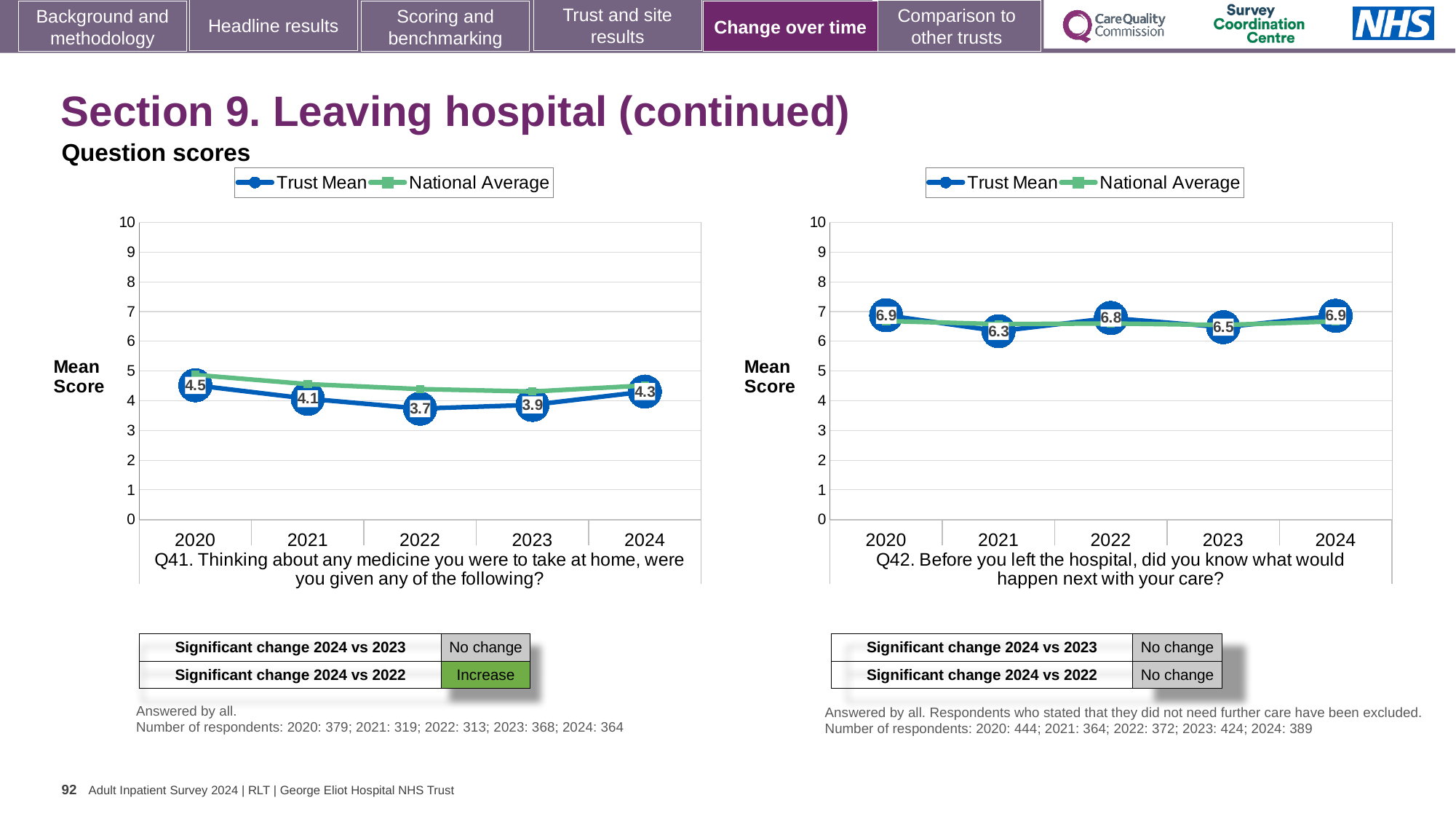
In the Q41 chart (left), is the National Average value for 2020 greater or less than 4? greater In the Q41 chart (left), what is the Trust Mean score for 2022? 3.7 In the Q42 chart (right), is the National Average value for 2021 greater or less than 6? greater In the Q42 chart (right), which year has the lowest Trust Mean score? 2021 In the Q41 chart (left), what is the difference between the Trust Mean scores for 2020 and 2022? 0.8 In the Q41 chart (left), which year has the highest Trust Mean score? 2020 How many series does the legend of the Q41 chart (left) list? 2 How many years are shown on the x axis of the Q42 chart (right)? 5 In the Q42 chart (right), what is the difference between the Trust Mean scores for 2024 and 2021? 0.6 In the Q42 chart (right), what is the Trust Mean score for 2023? 6.5 In the Q41 chart (left), is the Trust Mean score higher in 2021 or in 2023? 2021 What type of chart is used for Q41 (left)? Line chart